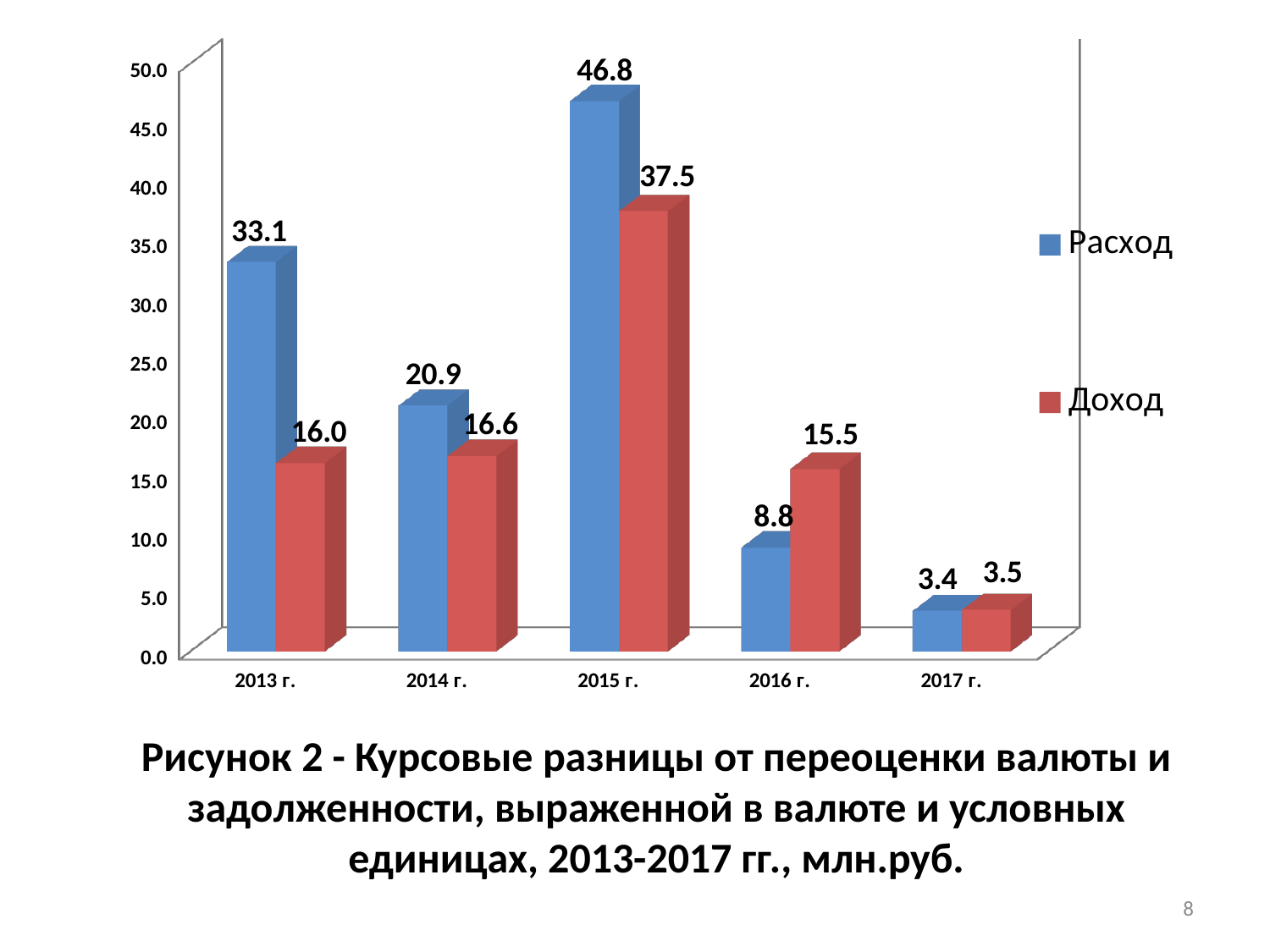
Does the Расход value rise or fall from 2015 г. to 2017 г.? fall What is the difference between Расход and Доход in 2013 г.? 17.1 What is the value of Доход for 2016 г.? 15.5 What kind of chart is shown on the slide? bar chart What is the value of Расход for 2015 г.? 46.8 How many series does the legend list? 2 What is the value of Доход for 2013 г.? 16.0 Which year has the lowest Доход value? 2017 г. How many years are shown on the x axis? 5 Which year has the highest Расход value? 2015 г. Is the Расход value for 2014 г. greater or less than 25.0? less Which is larger in 2016 г., Расход or Доход? Доход